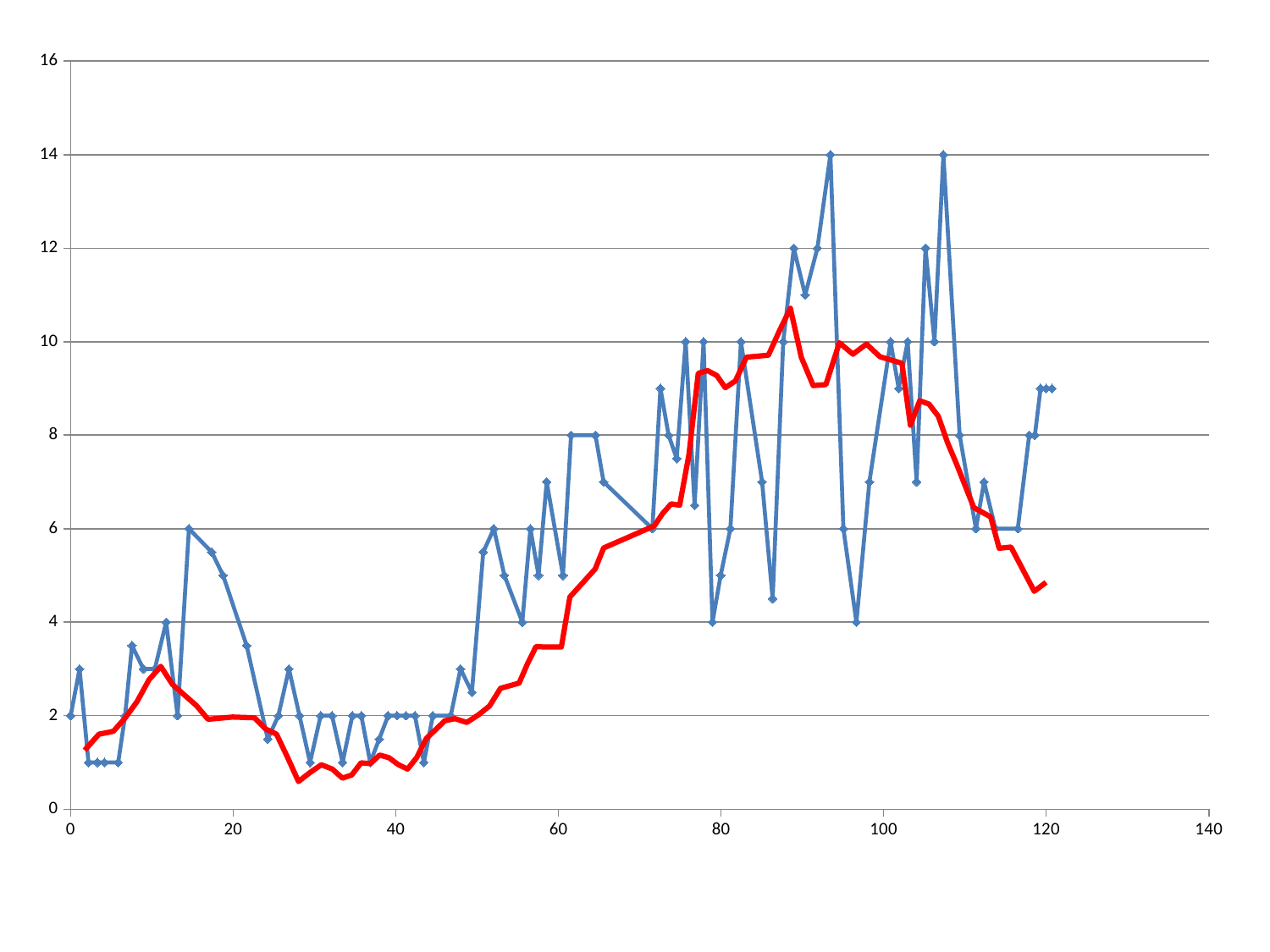
What kind of chart is shown on the slide? line chart Is the peak of the red line greater or less than 10? greater Is the value of the blue series at x = 0 greater or less than 4? less What is the maximum value shown on the y axis? 16 Is the value of the red line at x = 80 greater or less than 8? greater Between x = 40 and x = 80, does the red line rise or fall? rise Which line reaches a higher peak, the blue series or the red line? the blue series How many lines are plotted on the chart? 2 Between x = 100 and x = 120, does the red line rise or fall? fall What is the highest value reached by the blue series with markers? 14